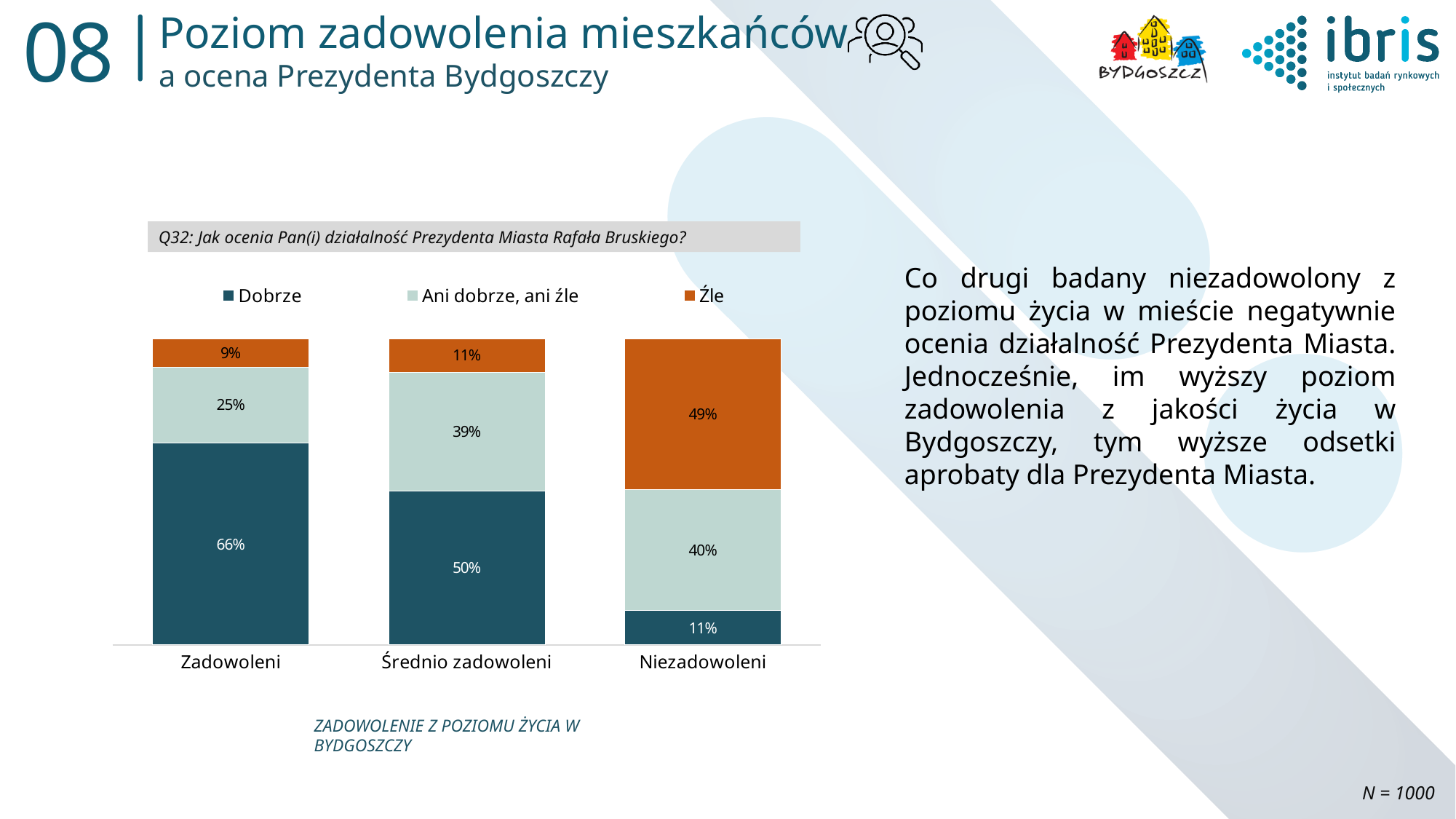
Which group has the highest 'Dobrze' share? Zadowoleni What is the 'Dobrze' value for the 'Niezadowoleni' group? 11% What is the difference between the 'Dobrze' share of 'Zadowoleni' and that of 'Średnio zadowoleni'? 16 percentage points How many series does the legend list? 3 What percentage of the 'Niezadowoleni' group rated the President 'Źle'? 49% What is the total of the stacked bar for 'Średnio zadowoleni'? 100% Which group has the lowest 'Źle' share? Zadowoleni What is the 'Ani dobrze, ani źle' value for the 'Średnio zadowoleni' group? 39% What percentage of the 'Zadowoleni' group rated the President 'Dobrze'? 66% Which is larger: the 'Źle' share for 'Niezadowoleni' or the 'Ani dobrze, ani źle' share for 'Niezadowoleni'? Źle (49%) How many groups are shown on the x axis of the chart? 3 What type of chart is shown on the slide? Stacked bar chart